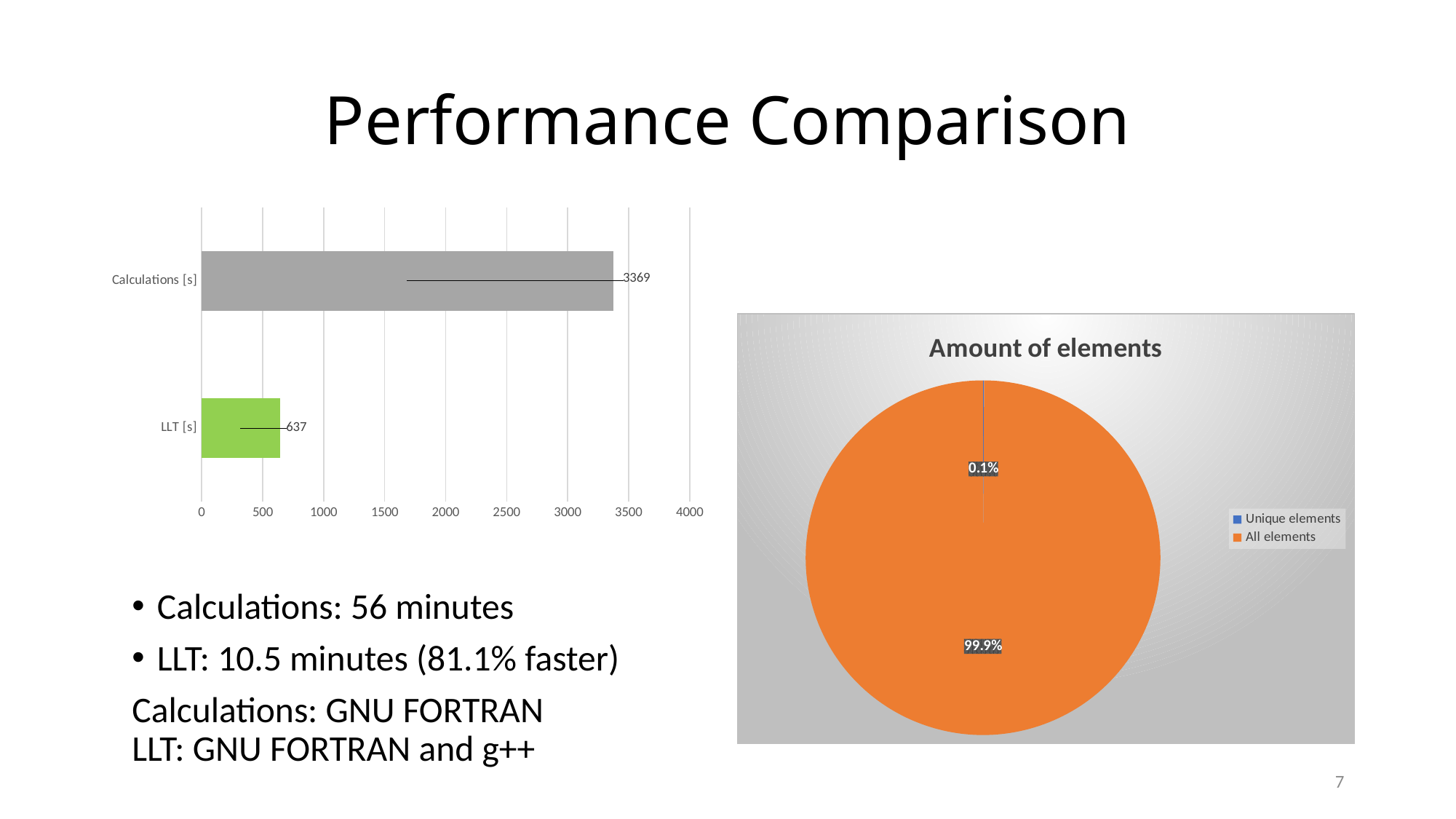
In the 'Amount of elements' chart, what share of the pie is All elements? 99.9% In the bar chart on the left, which category has the lowest value? LLT [s] In the bar chart on the left, which category has the highest value? Calculations [s] In the bar chart on the left, is the value for LLT [s] greater or less than 1000? less In the 'Amount of elements' chart, how many entries does the legend list? 2 What kind of chart is the chart on the left of the slide? bar chart In the 'Amount of elements' chart, what share of the pie is Unique elements? 0.1% In the bar chart on the left, what is the value for Calculations [s]? 3369 In the bar chart on the left, what is the value for LLT [s]? 637 In the bar chart on the left, what is the difference between the Calculations [s] and LLT [s] values? 2732 In the bar chart on the left, how many categories are plotted? 2 What kind of chart is the 'Amount of elements' chart? pie chart